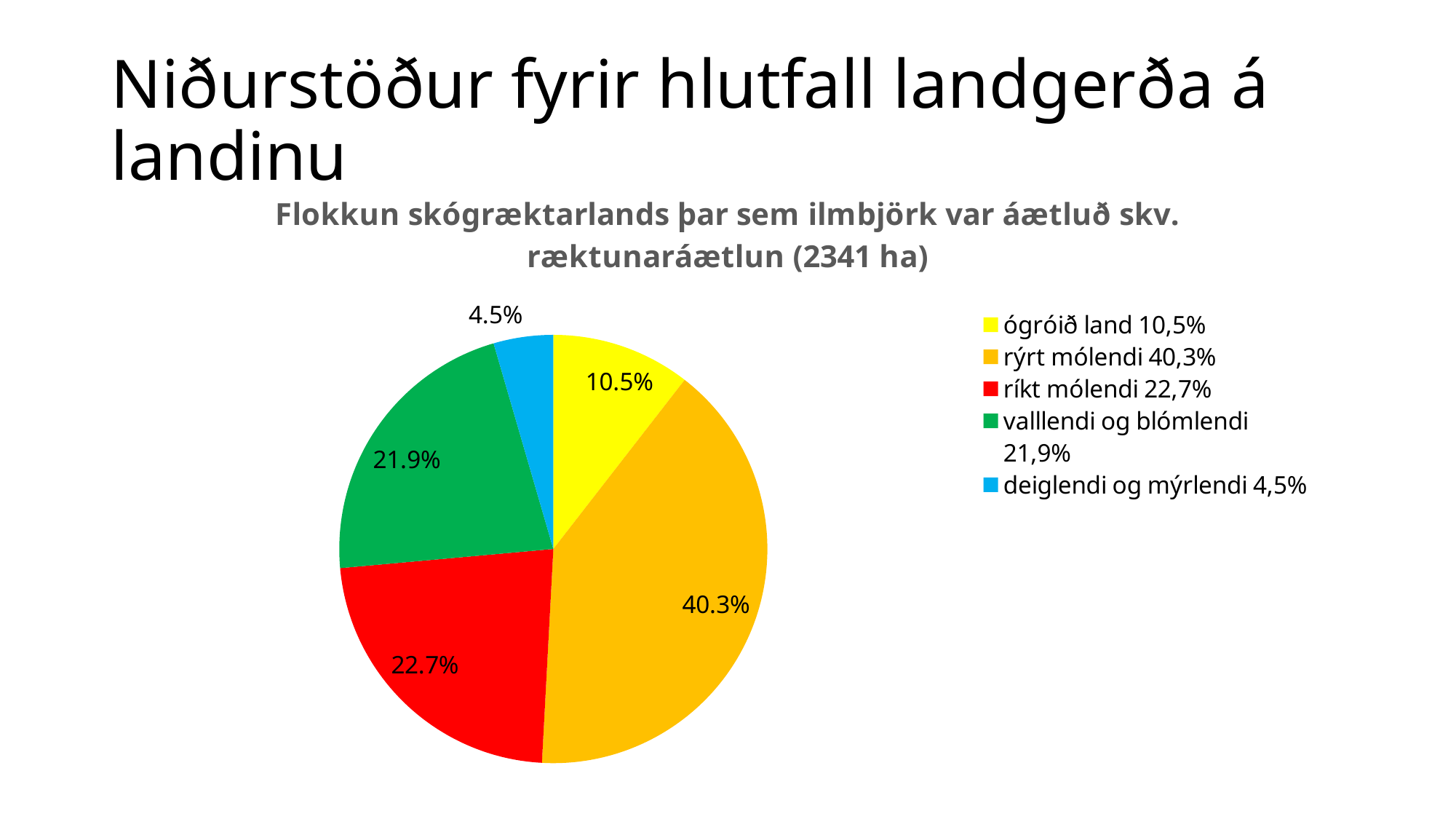
What share of the pie does valllendi og blómlendi have? 21.9% What share of the pie does deiglendi og mýrlendi have? 4.5% Which category has the smallest slice of the pie? deiglendi og mýrlendi What share of the pie does ríkt mólendi have? 22.7% What colour is the slice for deiglendi og mýrlendi? blue What is the difference in percentage points between rýrt mólendi and ríkt mólendi? 17.6 Which is larger, the share for ríkt mólendi or the share for valllendi og blómlendi? ríkt mólendi What kind of chart is shown on the slide? pie chart Which category has the largest slice of the pie? rýrt mólendi How many categories does the pie chart show? 5